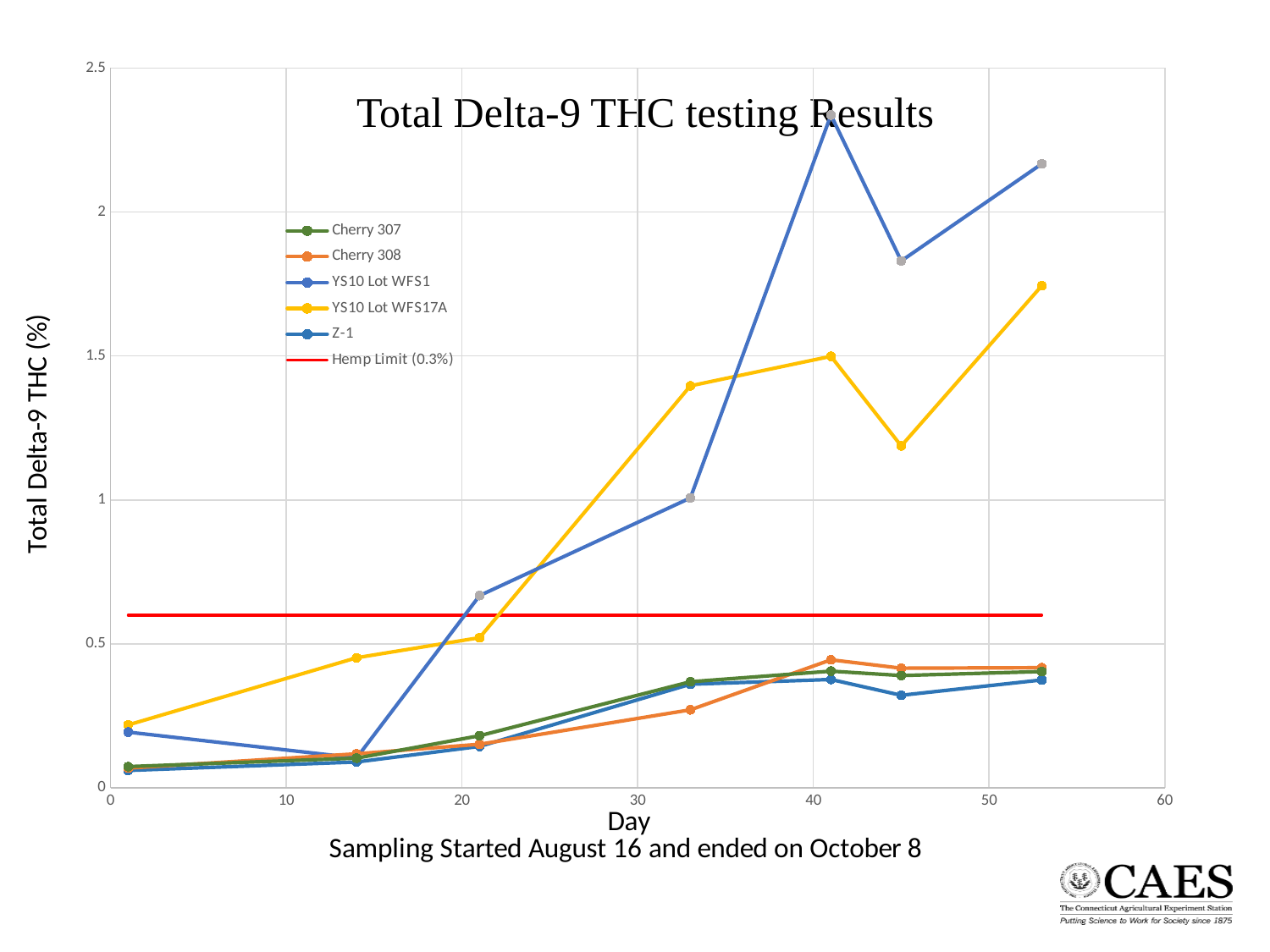
At day 53, which series has the larger value, YS10 Lot WFS1 or YS10 Lot WFS17A? YS10 Lot WFS1 What kind of chart is shown on the slide? line chart Is the value for Cherry 308 at day 53 greater or less than 0.5? less What is the title of the chart? Total Delta-9 THC testing Results What is the label of the x axis? Day Does the YS10 Lot WFS17A series generally rise or fall from day 1 to day 53? rise Is the value for YS10 Lot WFS17A at day 45 greater or less than 1? greater How many entries does the chart legend list? 6 Is the value for YS10 Lot WFS1 at day 41 greater or less than 2? greater Which series reaches the highest Total Delta-9 THC value on the chart? YS10 Lot WFS1